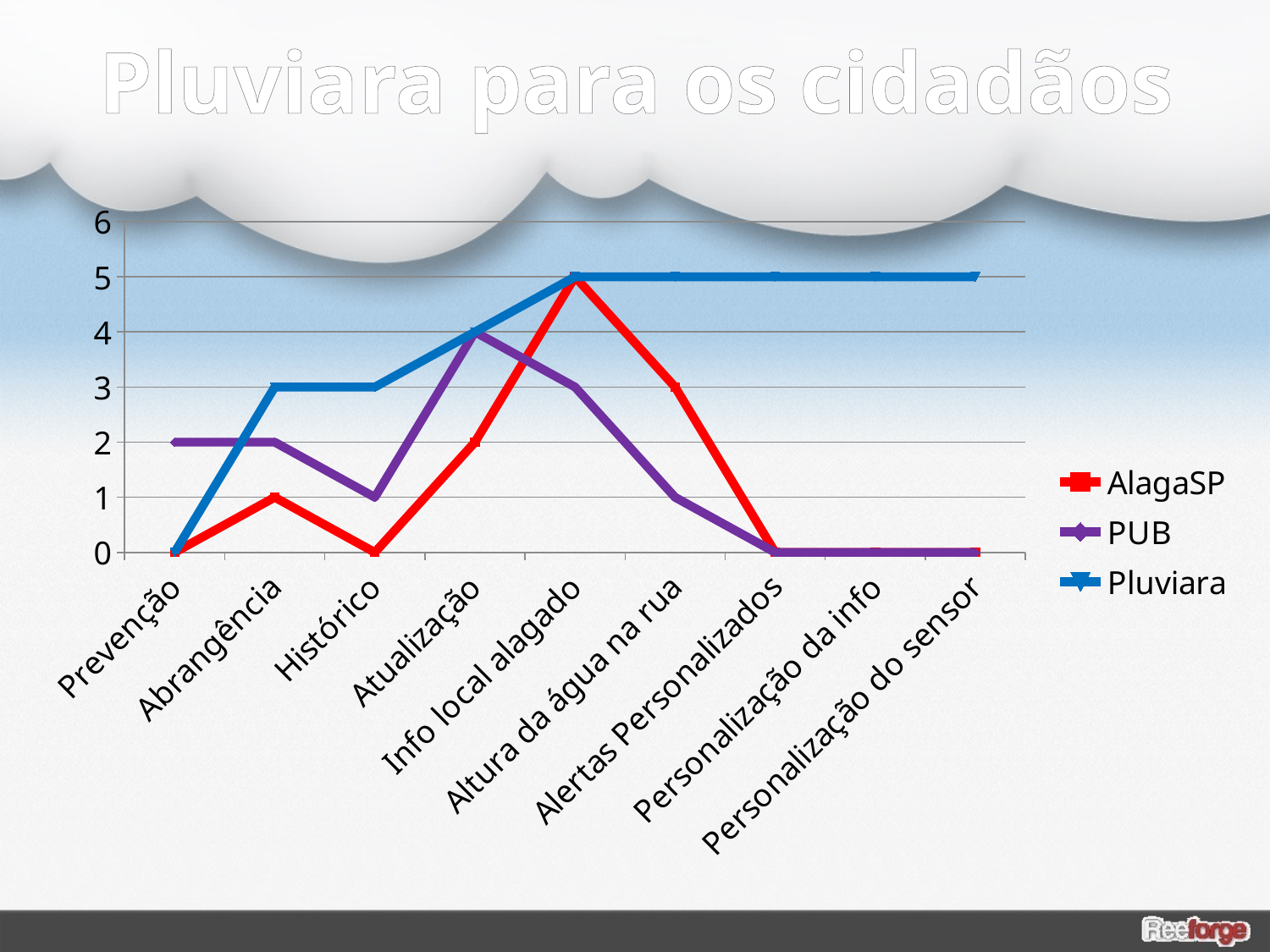
Which colour is used for the PUB series? purple What is the value for PUB at Atualização? 4 What kind of chart is shown on the slide? line chart How many categories are shown on the x axis? 9 At which category does AlagaSP reach its highest value? Info local alagado How many series does the legend list? 3 Does the Pluviara line rise or fall from Prevenção to Info local alagado? rise What is the difference between Pluviara and AlagaSP at Altura da água na rua? 2 What is the value for AlagaSP at Info local alagado? 5 Which series has the higher value at Altura da água na rua, AlagaSP or PUB? AlagaSP What is the value for PUB at Prevenção? 2 What is the value for Pluviara at Abrangência? 3